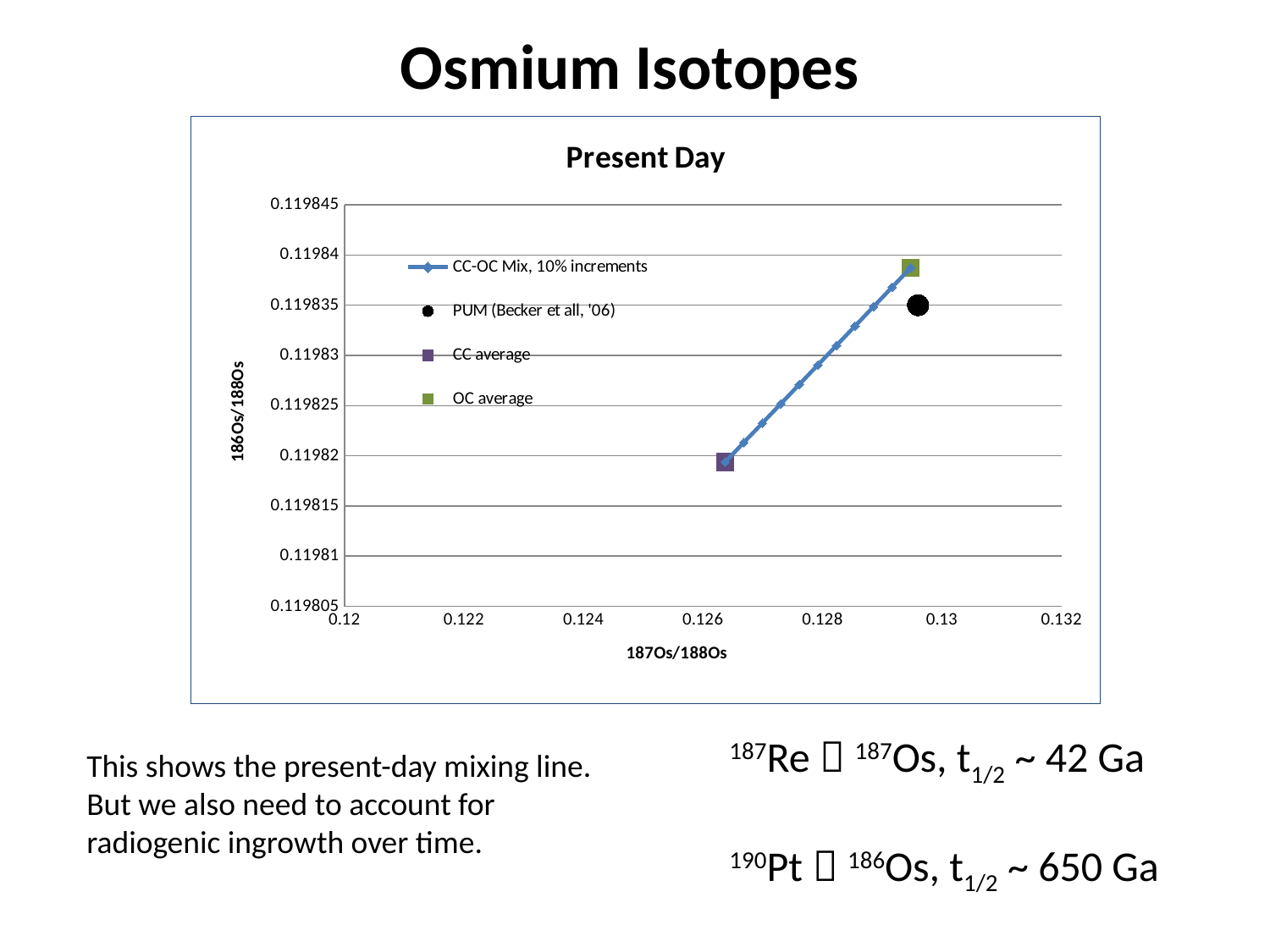
Which has the larger 187Os/188Os value, CC average or PUM (Becker et all, '06)? PUM (Becker et all, '06) What kind of chart is shown on the slide? scatter chart Is the 186Os/188Os value for OC average greater or less than 0.11983? greater Which has the higher 186Os/188Os value, CC average or OC average? OC average How many series does the chart legend list? 4 Is the 187Os/188Os value for CC average greater or less than 0.128? less What is the label of the x axis? 187Os/188Os What is the title of the chart? Present Day Is the 187Os/188Os value for PUM (Becker et all, '06) greater or less than 0.128? greater Does the CC-OC Mix line rise or fall as 187Os/188Os increases? rise